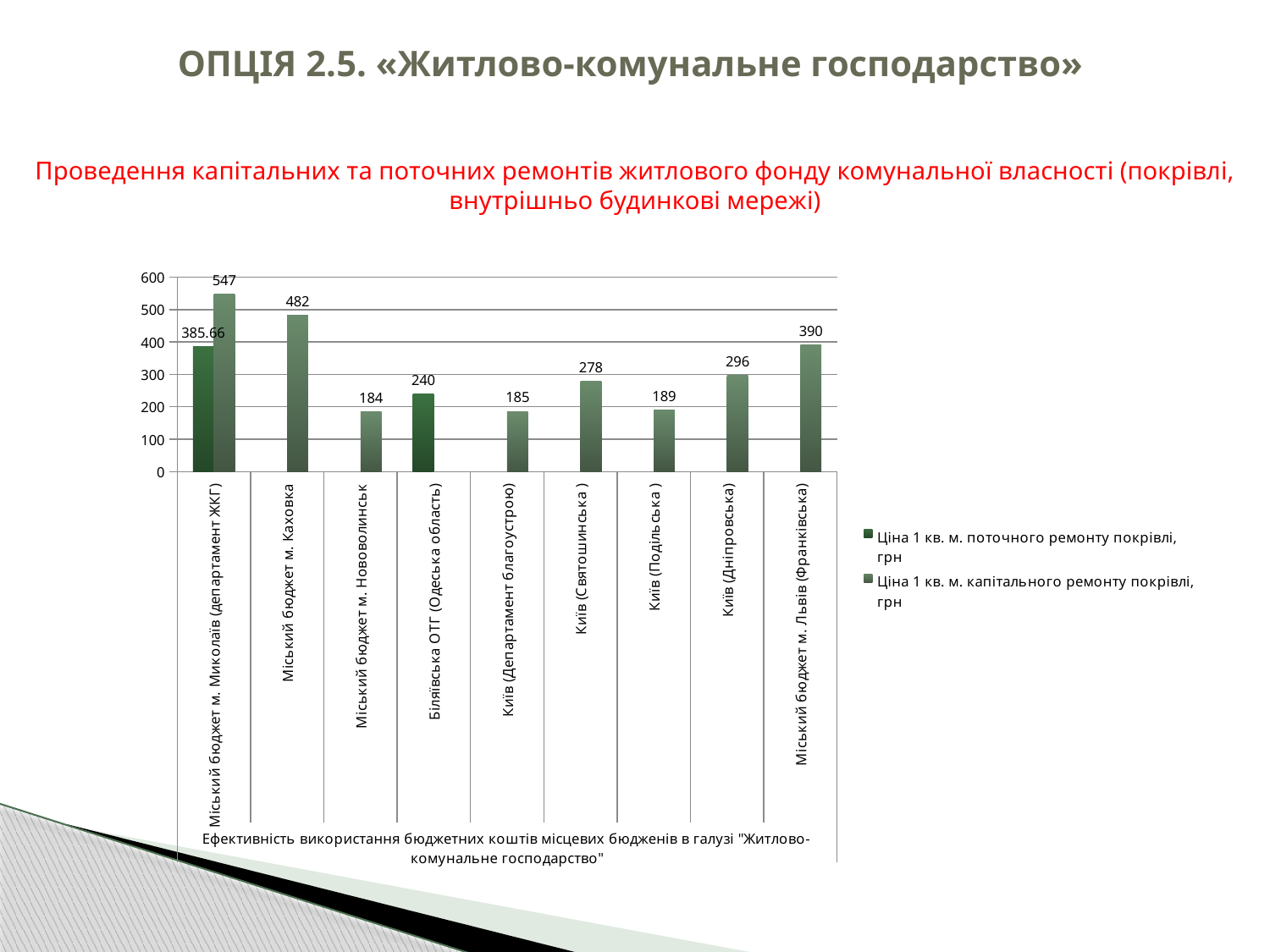
What is the value shown for Біляївська ОТГ (Одеська область)? 240 Which is larger: the capital repair price for Київ (Святошинська) or for Київ (Подільська)? Київ (Святошинська) What is the value of 'Ціна 1 кв. м. поточного ремонту покрівлі, грн' for Міський бюджет м. Миколаїв (департамент ЖКГ)? 385.66 What is the x-axis title of the chart? Ефективність використання бюджетних коштів місцевих бюдженів в галузі "Житлово-комунальне господарство" How many categories are shown on the x axis of the chart? 9 What is the difference between the capital repair price for Міський бюджет м. Львів (Франківська) and for Київ (Дніпровська)? 94 Which category has the lowest value for 'Ціна 1 кв. м. капітального ремонту покрівлі, грн'? Міський бюджет м. Нововолинськ What is the value of 'Ціна 1 кв. м. капітального ремонту покрівлі, грн' for Міський бюджет м. Миколаїв (департамент ЖКГ)? 547 What type of chart is shown on the slide? bar chart What is the value of 'Ціна 1 кв. м. капітального ремонту покрівлі, грн' for Міський бюджет м. Каховка? 482 How many series does the legend list? 2 Which category has the highest value for 'Ціна 1 кв. м. капітального ремонту покрівлі, грн'? Міський бюджет м. Миколаїв (департамент ЖКГ)